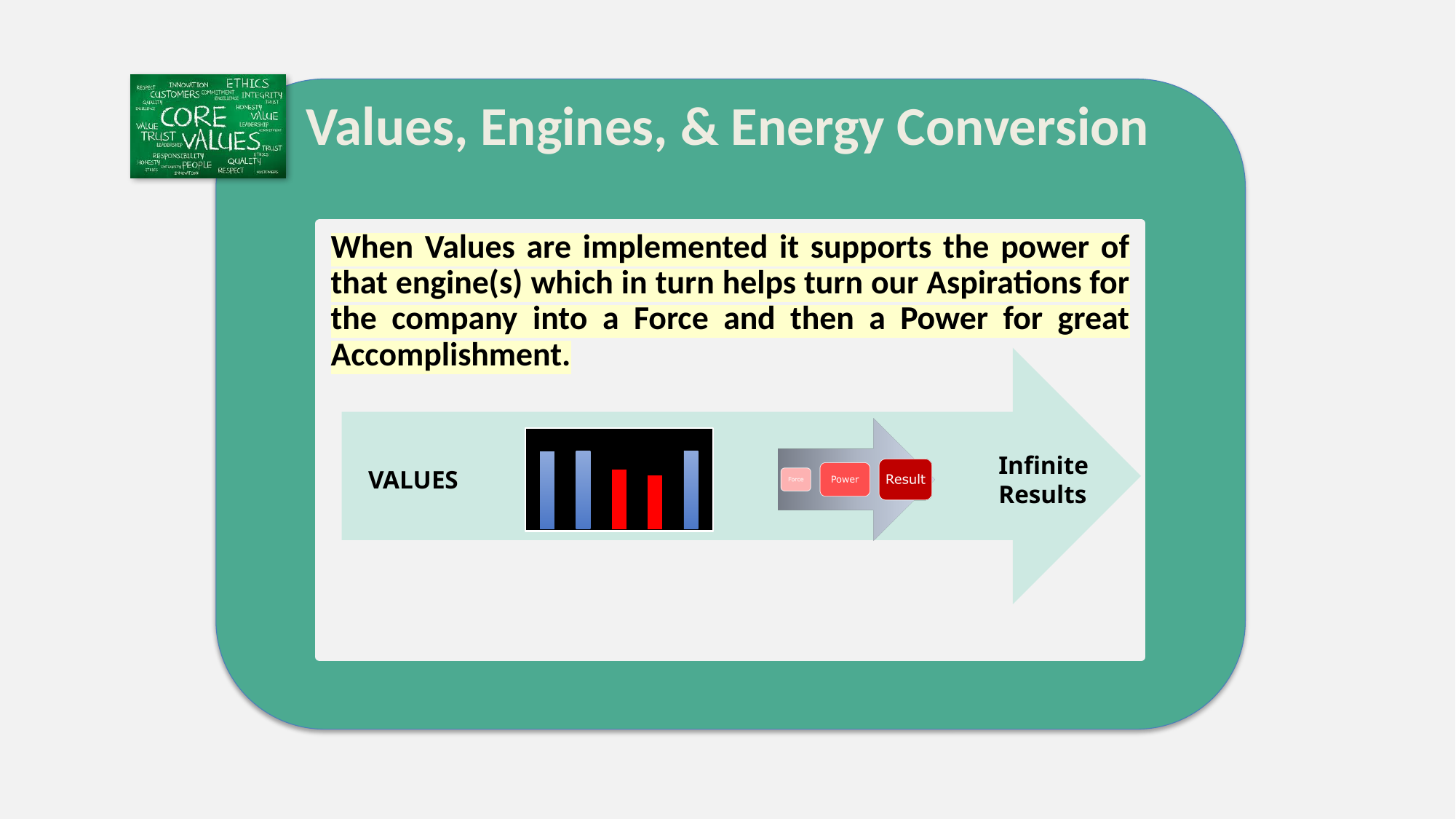
In the bar chart, are the red bars taller or shorter than the blue bars? shorter Does the bar chart on the slide show any axis labels or data values? No How many of the bars in the chart are blue? 3 How many of the bars in the chart are red? 2 How many bars does the bar chart on the slide contain? 5 What kind of chart is shown in the black panel next to the word VALUES? bar chart